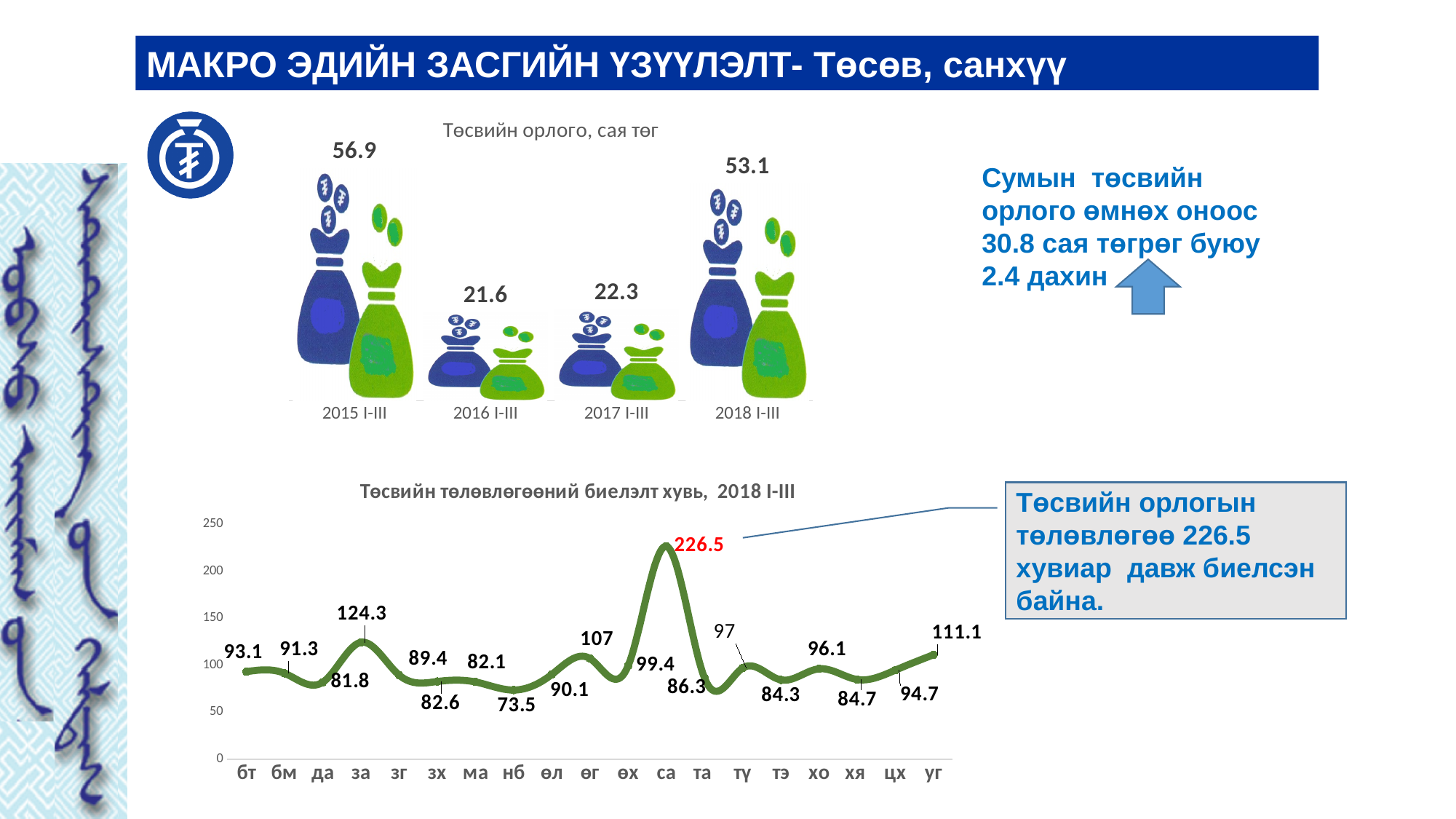
In the chart 'Төсвийн орлого, сая төг', what is the value for 2018 I-III? 53.1 In the chart 'Төсвийн орлого, сая төг', which period has the lowest value? 2016 I-III In the chart 'Төсвийн орлого, сая төг', what is the difference between the 2018 I-III and 2017 I-III values? 30.8 In the chart 'Төсвийн төлөвлөгөөний биелэлт хувь, 2018 I-III', how many categories are on the x axis? 19 In the chart 'Төсвийн төлөвлөгөөний биелэлт хувь, 2018 I-III', which category has the lowest value? нб In the chart 'Төсвийн төлөвлөгөөний биелэлт хувь, 2018 I-III', which is larger, the value for за or the value for уг? за In the chart 'Төсвийн төлөвлөгөөний биелэлт хувь, 2018 I-III', what is the value for са? 226.5 In the chart 'Төсвийн төлөвлөгөөний биелэлт хувь, 2018 I-III', what is the value for нб? 73.5 What kind of chart is 'Төсвийн төлөвлөгөөний биелэлт хувь, 2018 I-III'? line chart In the chart 'Төсвийн орлого, сая төг', which period has the highest value? 2015 I-III In the chart 'Төсвийн орлого, сая төг', how many periods are shown? 4 In the chart 'Төсвийн төлөвлөгөөний биелэлт хувь, 2018 I-III', what is the difference between the values for өг and өх? 7.6